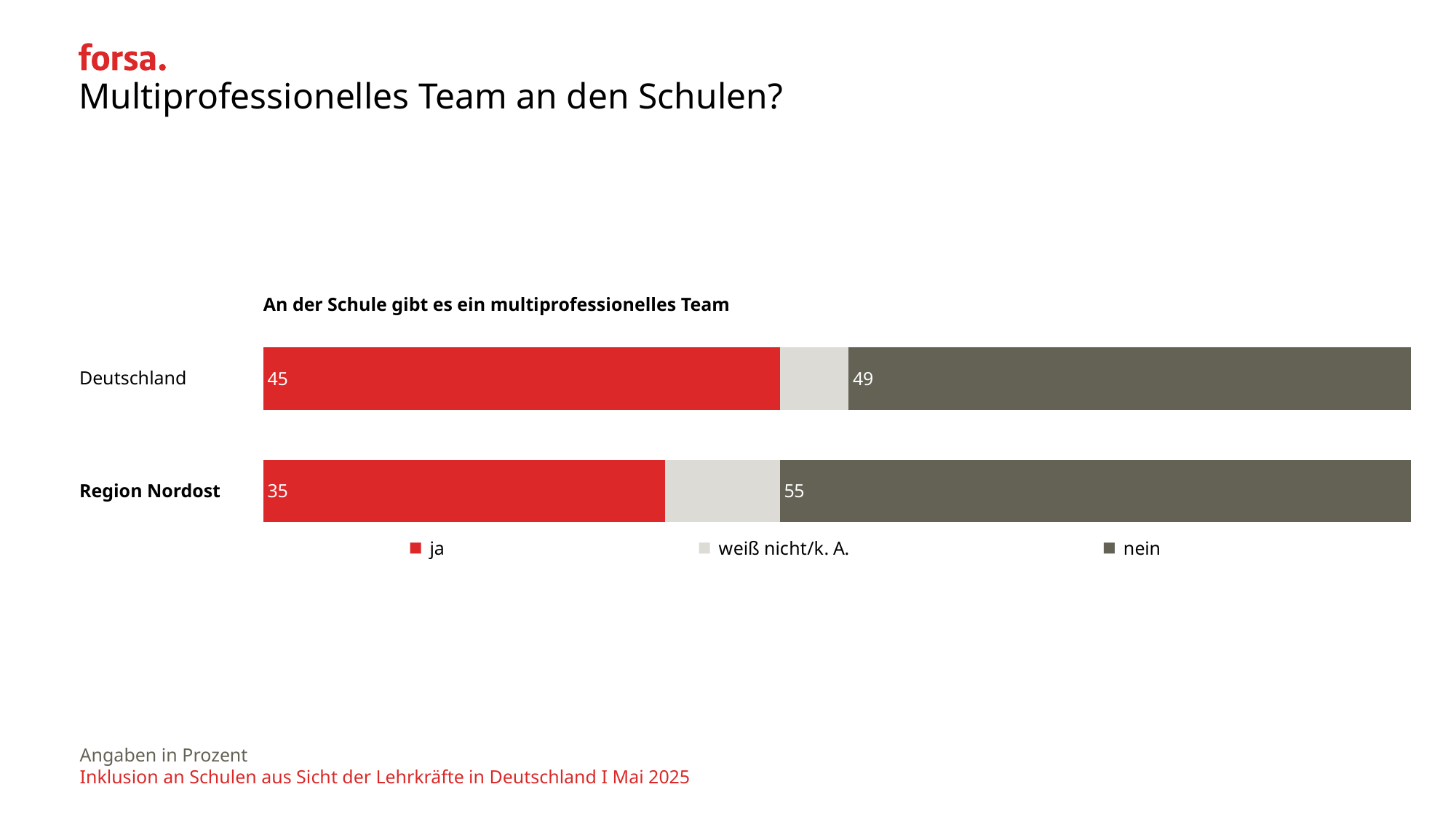
Which category has the higher value for "ja"? Deutschland What is the value for "ja" for Deutschland? 45 Is the "nein" value for Region Nordost larger or smaller than the "ja" value for Region Nordost? larger What is the value for "nein" for Deutschland? 49 How many categories are shown in the chart? 2 What is the difference between the "nein" values for Region Nordost and Deutschland? 6 What is the value for "nein" for Region Nordost? 55 What kind of chart is shown on the slide? stacked bar chart What is the difference between the "ja" values for Deutschland and Region Nordost? 10 What is the value for "ja" for Region Nordost? 35 How many series does the legend list? 3 Which category has the lower value for "nein"? Deutschland